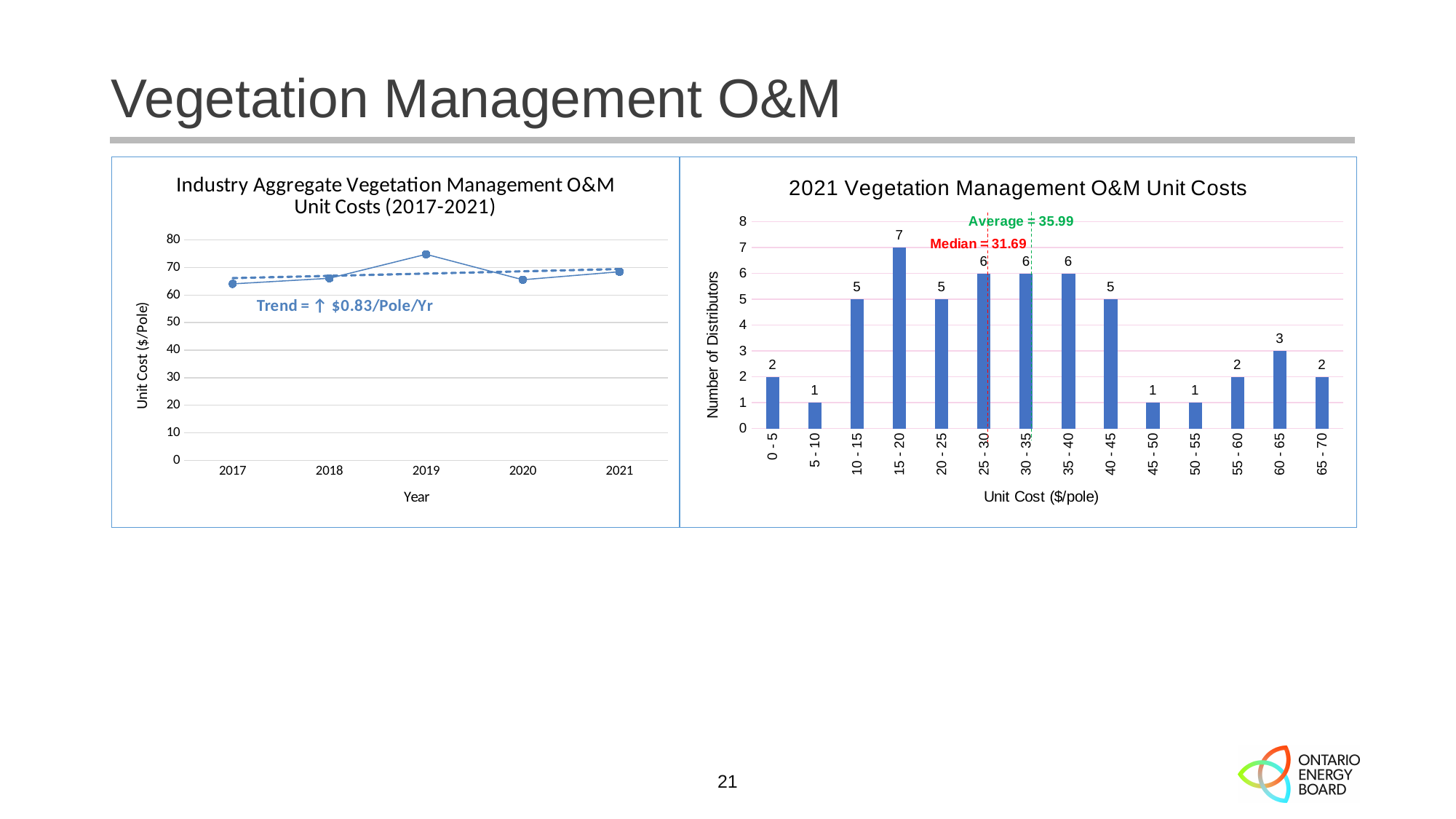
In the '2021 Vegetation Management O&M Unit Costs' chart, how many distributors are in the 60 - 65 bin? 3 In the '2021 Vegetation Management O&M Unit Costs' chart, what average value is annotated? 35.99 What kind of chart is the 'Industry Aggregate Vegetation Management O&M Unit Costs (2017-2021)' chart? Line chart In the 'Industry Aggregate Vegetation Management O&M Unit Costs (2017-2021)' chart, is the unit cost for 2019 greater or less than 70? greater In the '2021 Vegetation Management O&M Unit Costs' chart, which unit cost bin has the highest number of distributors? 15 - 20 In the '2021 Vegetation Management O&M Unit Costs' chart, how many unit cost bins are shown on the x axis? 14 In the '2021 Vegetation Management O&M Unit Costs' chart, how many distributors are in the 15 - 20 bin? 7 In the '2021 Vegetation Management O&M Unit Costs' chart, what is the difference between the number of distributors in the 15 - 20 bin and the 0 - 5 bin? 5 In the '2021 Vegetation Management O&M Unit Costs' chart, which bin has more distributors, 10 - 15 or 40 - 45? They are equal (5 each) In the 'Industry Aggregate Vegetation Management O&M Unit Costs (2017-2021)' chart, which year has the highest unit cost? 2019 What kind of chart is the '2021 Vegetation Management O&M Unit Costs' chart? Bar chart In the 'Industry Aggregate Vegetation Management O&M Unit Costs (2017-2021)' chart, what trend value is annotated? ↑ $0.83/Pole/Yr